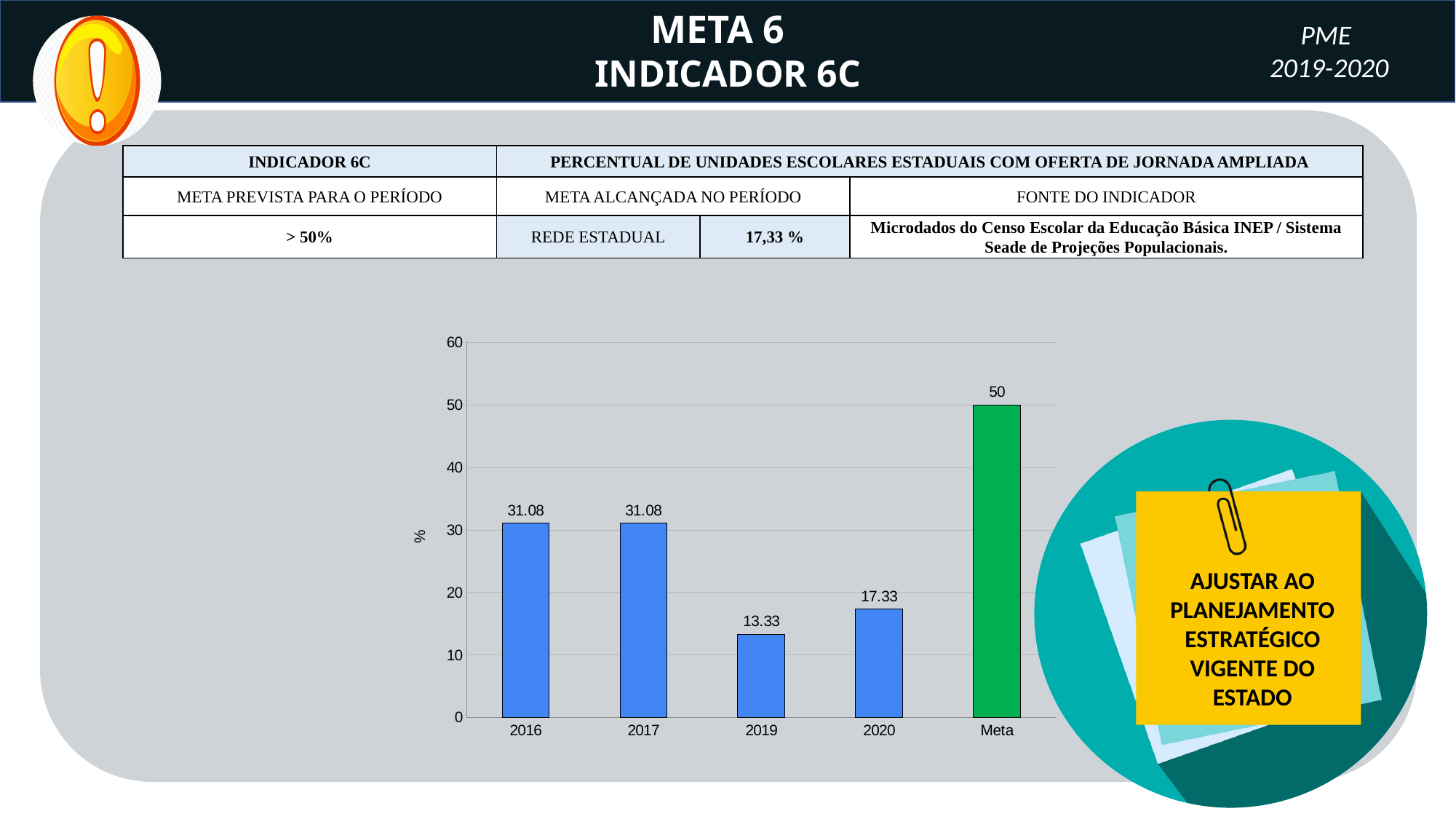
What is the value for 2016? 31.08 What is the value for 2019? 13.33 What is the label on the vertical axis of the chart? % Which is larger, the value for 2017 or the value for 2020? 2017 Which category has the lowest value? 2019 Which category has the highest value? Meta What is the difference between the Meta value and the 2020 value? 32.67 What kind of chart is shown on the slide? Bar chart What is the value for Meta? 50 What is the value for 2020? 17.33 How many bars are shown in the chart? 5 What is the difference between the 2020 value and the 2019 value? 4